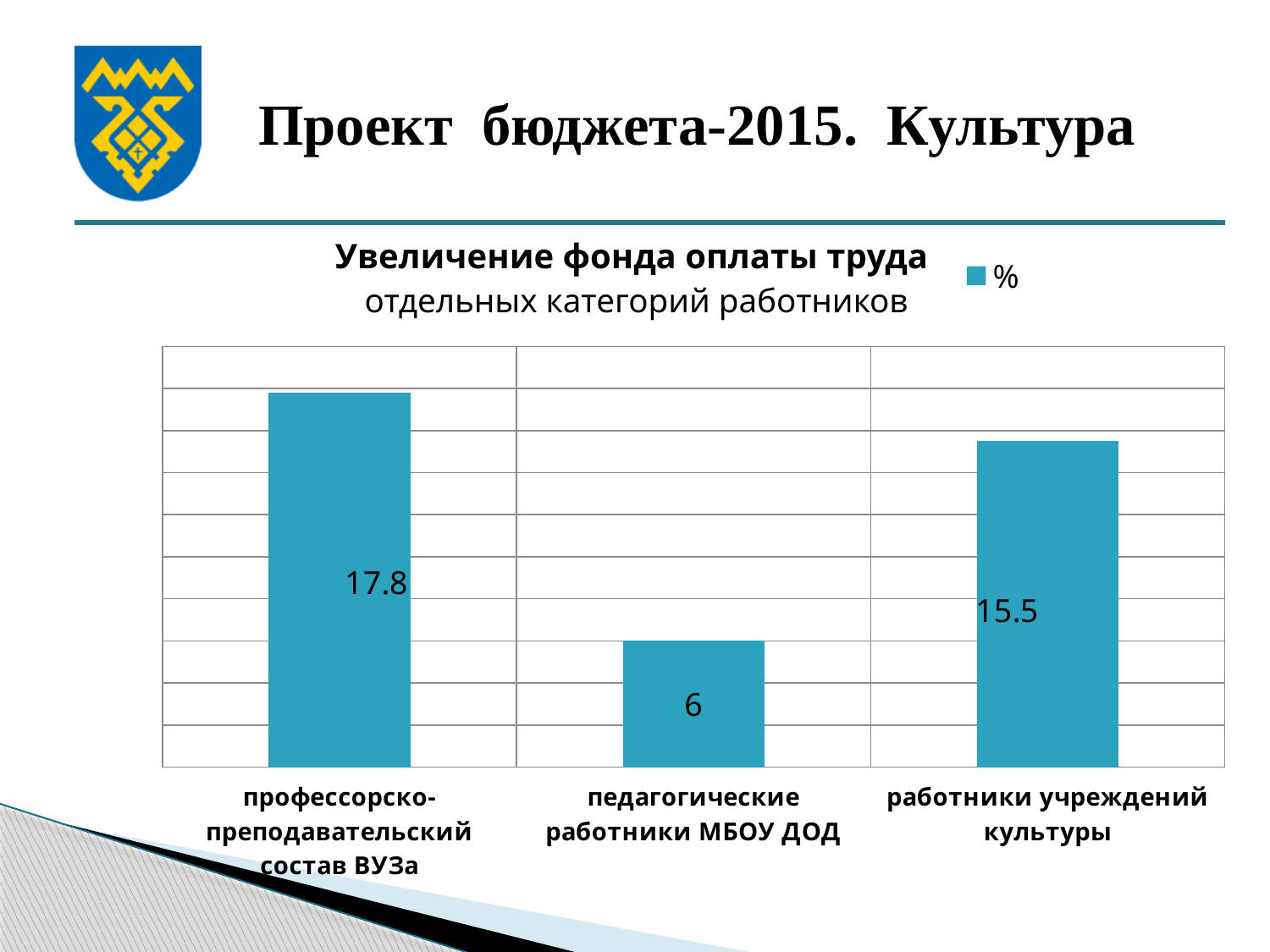
What is the value for работники учреждений культуры? 15.5 What is the value for профессорско-преподавательский состав ВУЗа? 17.8 Which is larger: the value for педагогические работники МБОУ ДОД or the value for работники учреждений культуры? работники учреждений культуры What is the difference between the values for профессорско-преподавательский состав ВУЗа and работники учреждений культуры? 2.3 What is the difference between the values for работники учреждений культуры and педагогические работники МБОУ ДОД? 9.5 What kind of chart is shown on the slide? bar chart What is the value for педагогические работники МБОУ ДОД? 6 Which category has the lowest value? педагогические работники МБОУ ДОД How many categories are shown in the chart? 3 What is the legend entry of the chart? % How many series does the legend list? 1 Which category has the highest value? профессорско-преподавательский состав ВУЗа